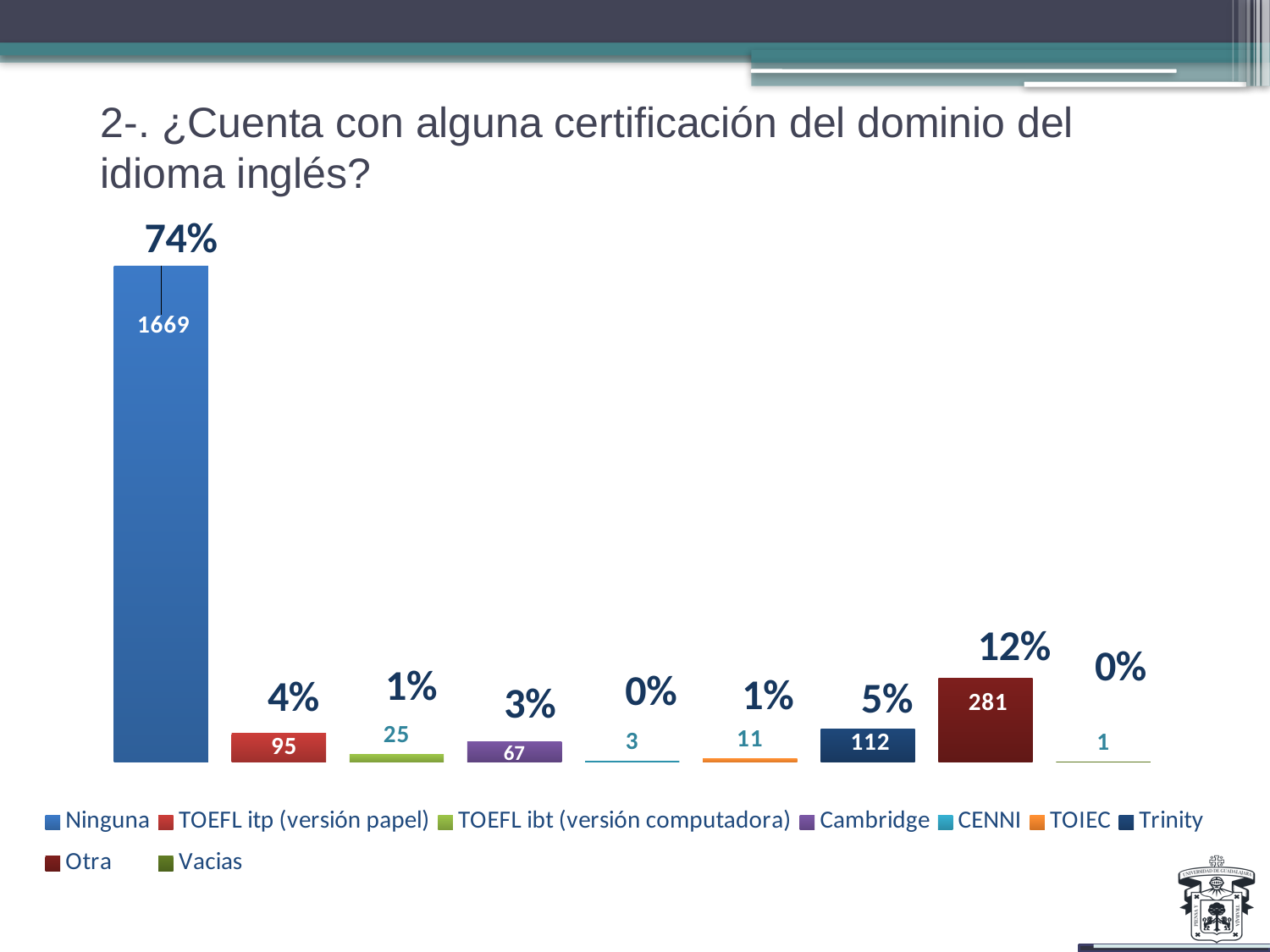
What kind of chart is shown on the slide? Bar chart What is the count shown for Cambridge? 67 What is the count shown for Ninguna? 1669 Which category has the highest count? Ninguna Which category has the lowest count? Vacias What is the count shown for Trinity? 112 Which has a larger count, TOEFL itp (versión papel) or TOEFL ibt (versión computadora)? TOEFL itp (versión papel) What percentage is shown above the CENNI bar? 0% What percentage is shown above the Otra bar? 12% What colour is the bar for Ninguna? Blue What is the difference between the counts for Otra and Trinity? 169 How many entries does the legend list? 9